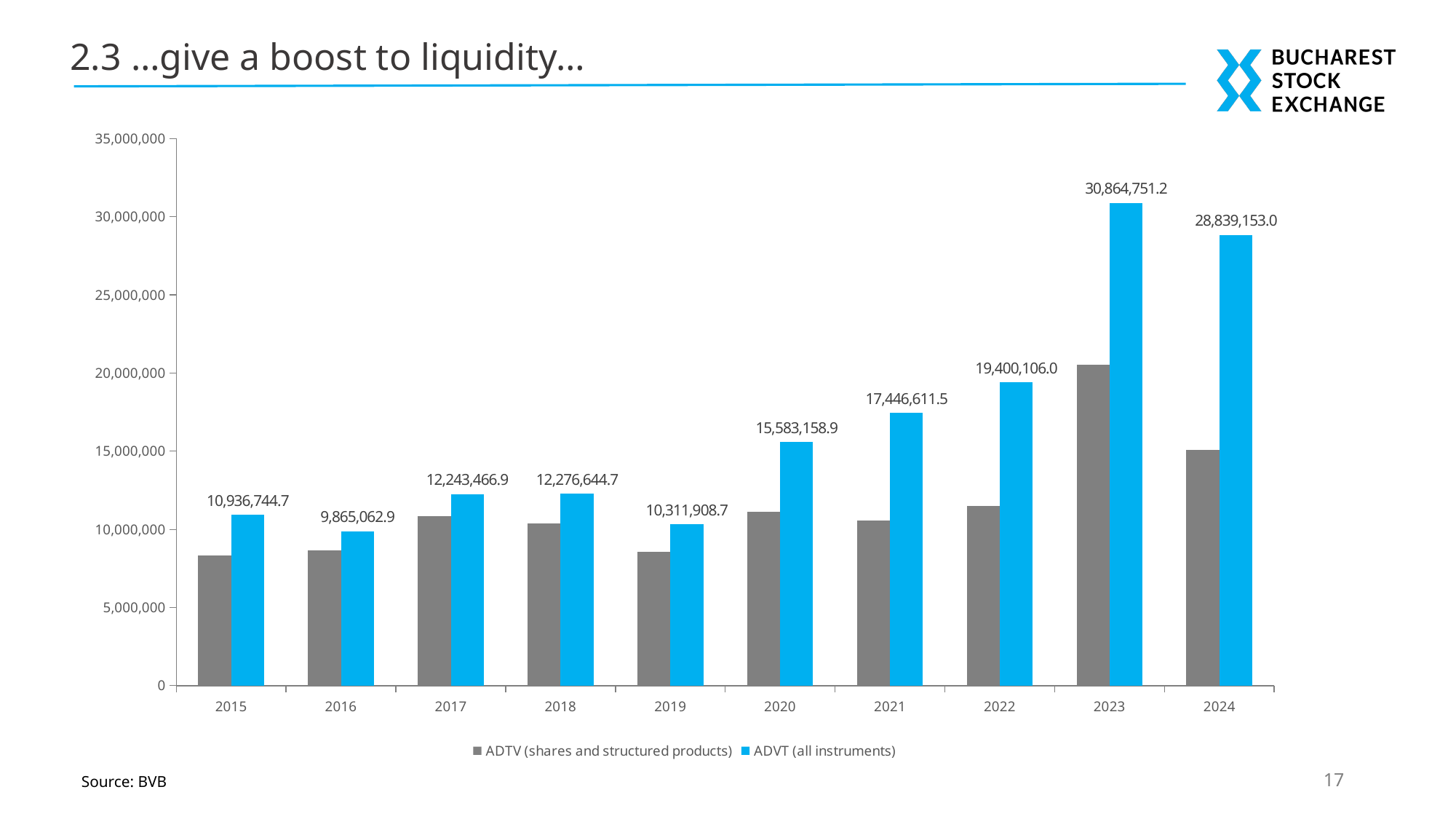
How many years are shown on the x axis of the chart? 10 Is the ADTV (shares and structured products) value for 2022 greater or less than 10,000,000? greater Is the ADTV (shares and structured products) value for 2015 greater or less than 10,000,000? less What is the ADVT (all instruments) value for 2020? 15,583,158.9 What is the ADVT (all instruments) value for 2023? 30,864,751.2 In which year is the ADVT (all instruments) value highest? 2023 What is the ADVT (all instruments) value for 2015? 10,936,744.7 Which year has the larger ADVT (all instruments) value, 2017 or 2018? 2018 In which year is the ADVT (all instruments) value lowest? 2016 What kind of chart is shown on the slide? Bar chart What is the difference between the ADVT (all instruments) values for 2023 and 2024? 2,025,598.2 How many series does the legend list? 2